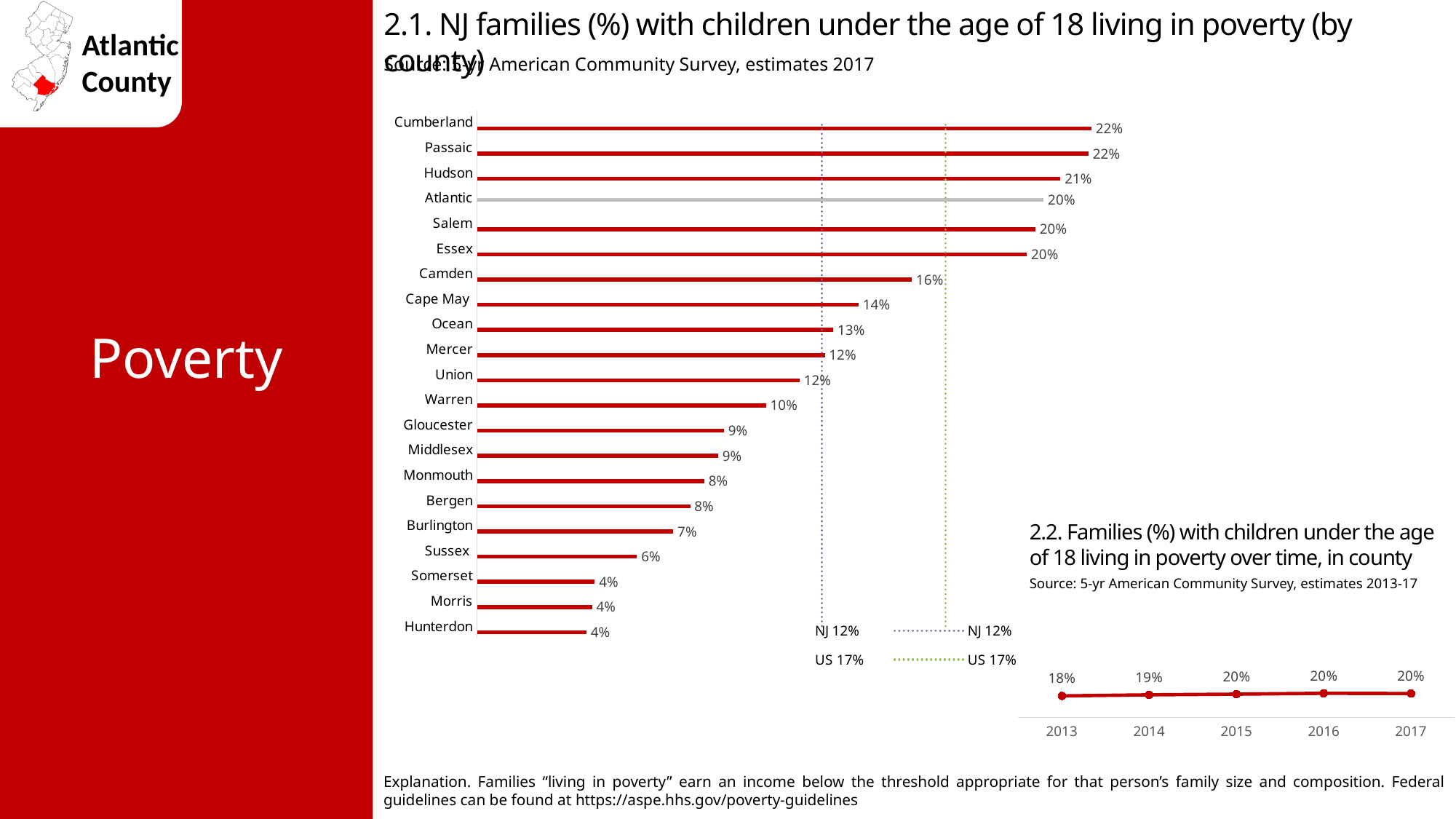
What kind of chart is chart 2.1 (by county)? Bar chart In chart 2.2 (over time, in county), do the values rise or fall from 2013 to 2017? Rise In chart 2.1 (by county), which has a higher value, Ocean or Warren? Ocean In chart 2.1 (by county), what is the value for Hunterdon? 4% In chart 2.1 (by county), what is the value for Camden? 16% In chart 2.1 (by county), how many counties are shown? 21 In chart 2.2 (over time, in county), how many years are plotted? 5 In chart 2.2 (families in poverty over time, in county), what is the value for 2013? 18% In chart 2.1 (by county), what is the difference between the values for Hudson and Cape May? 7% In chart 2.1 (by county), which county's bar is shown in grey rather than red? Atlantic In chart 2.1 (by county), what is the NJ reference value shown by the dotted line? 12% In chart 2.1 (NJ families with children under 18 living in poverty by county), what is the value for Atlantic? 20%